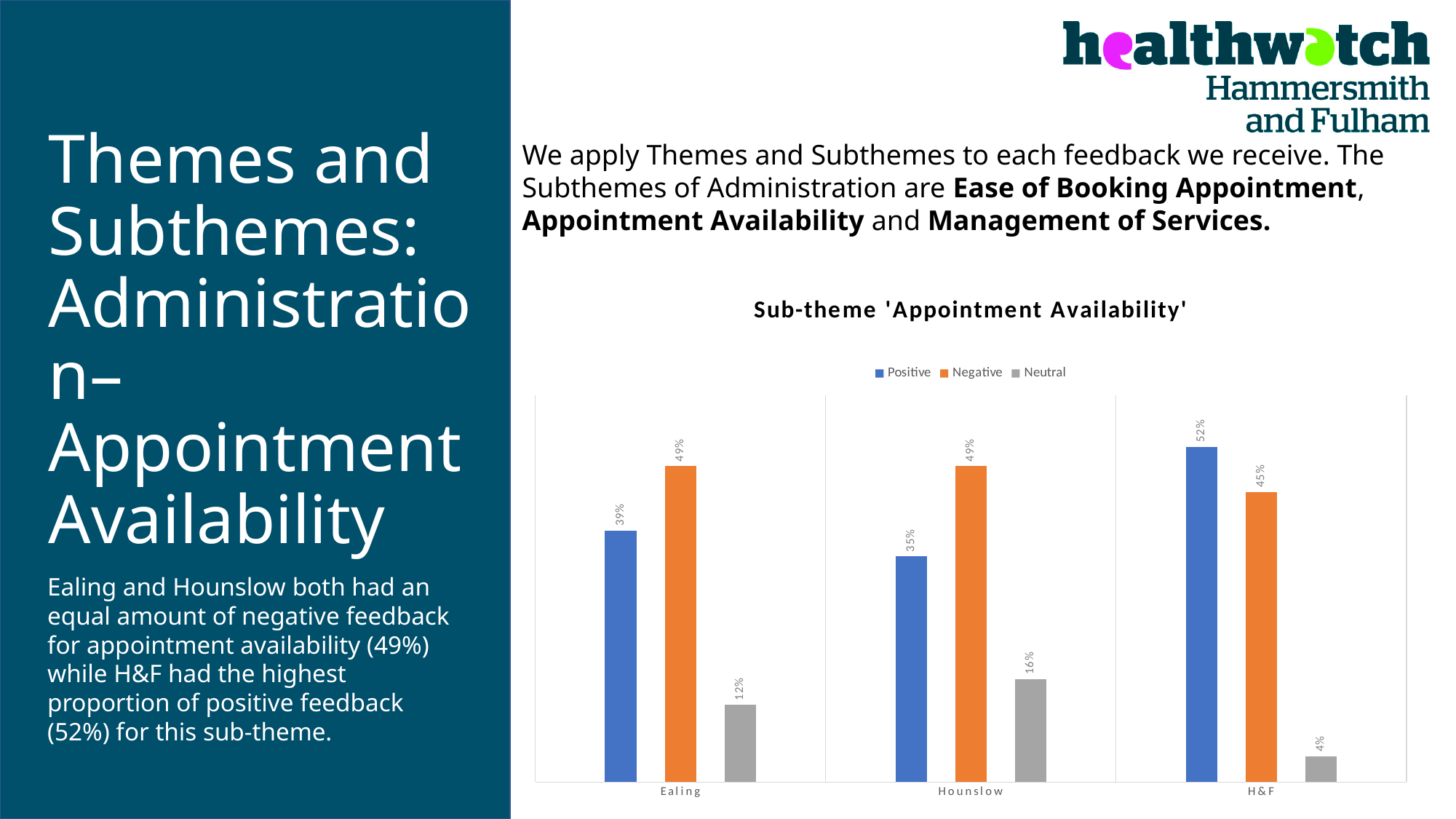
Which is larger for Hounslow, the Positive value or the Negative value? Negative What is the difference between the Negative and Positive values for Ealing? 10% How many series does the legend list? 3 Which category has the highest Positive value? H&F How many categories are shown on the x axis? 3 What is the Positive value for Ealing? 39% Which category has the lowest Neutral value? H&F What is the Positive value for H&F? 52% What is the Negative value for Hounslow? 49% What is the title of the chart? Sub-theme 'Appointment Availability' What is the Neutral value for H&F? 4% What kind of chart is shown on the slide? Bar chart